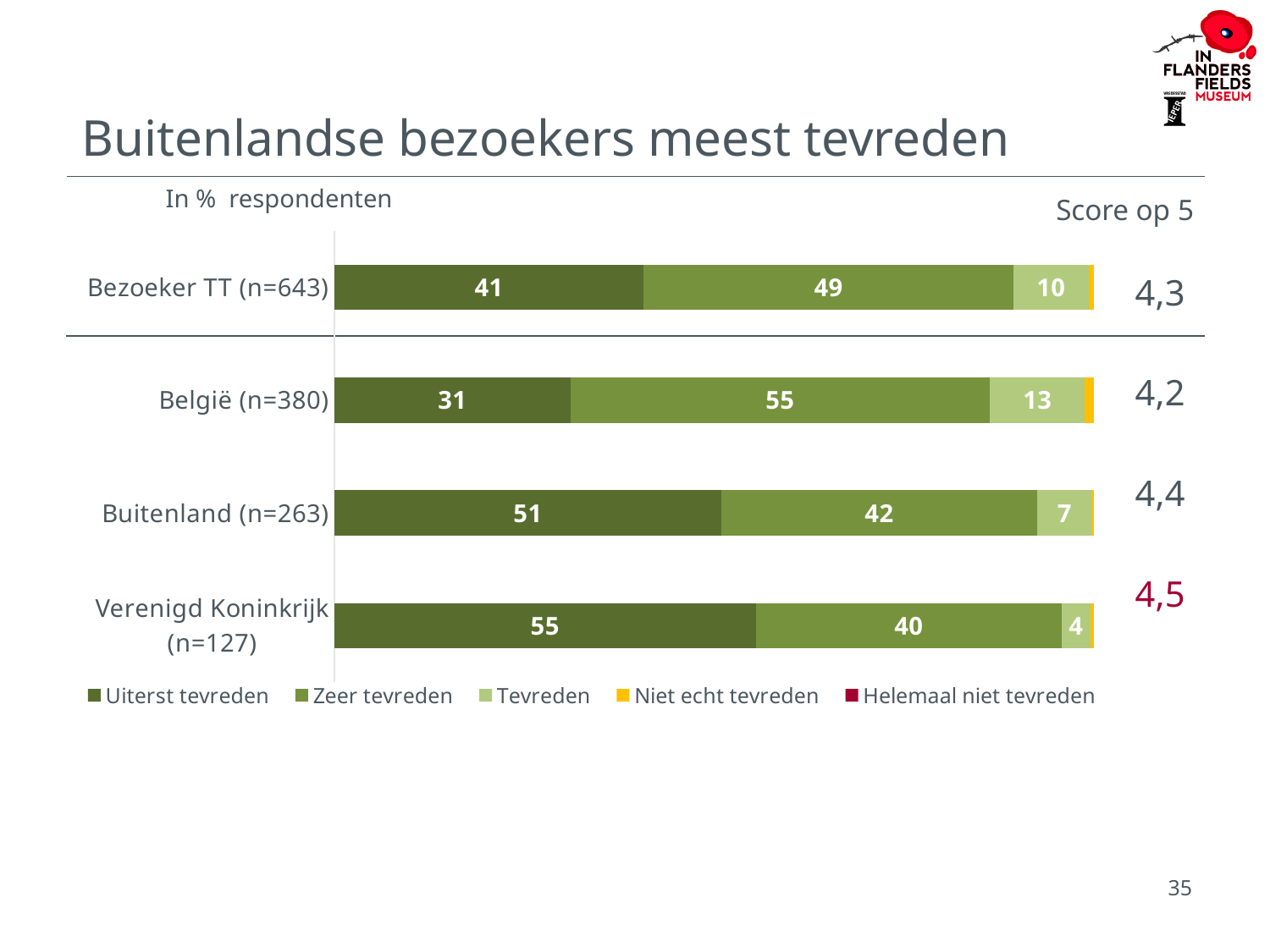
Which is larger: the 'Zeer tevreden' value for Bezoeker TT (n=643) or for Buitenland (n=263)? Bezoeker TT (n=643) What is the difference between the 'Uiterst tevreden' values for Verenigd Koninkrijk (n=127) and België (n=380)? 24 Which category has the lowest 'Uiterst tevreden' value? België (n=380) What score on 5 is shown for Verenigd Koninkrijk (n=127)? 4,5 How many series does the legend list? 5 Which category has the lowest score on 5? België (n=380) What is the 'Zeer tevreden' value for België (n=380)? 55 Which category has the highest 'Uiterst tevreden' value? Verenigd Koninkrijk (n=127) How many categories are shown on the chart? 4 What is the 'Uiterst tevreden' value for Buitenland (n=263)? 51 What kind of chart is shown on the slide? Stacked bar chart What is the 'Tevreden' value for Bezoeker TT (n=643)? 10